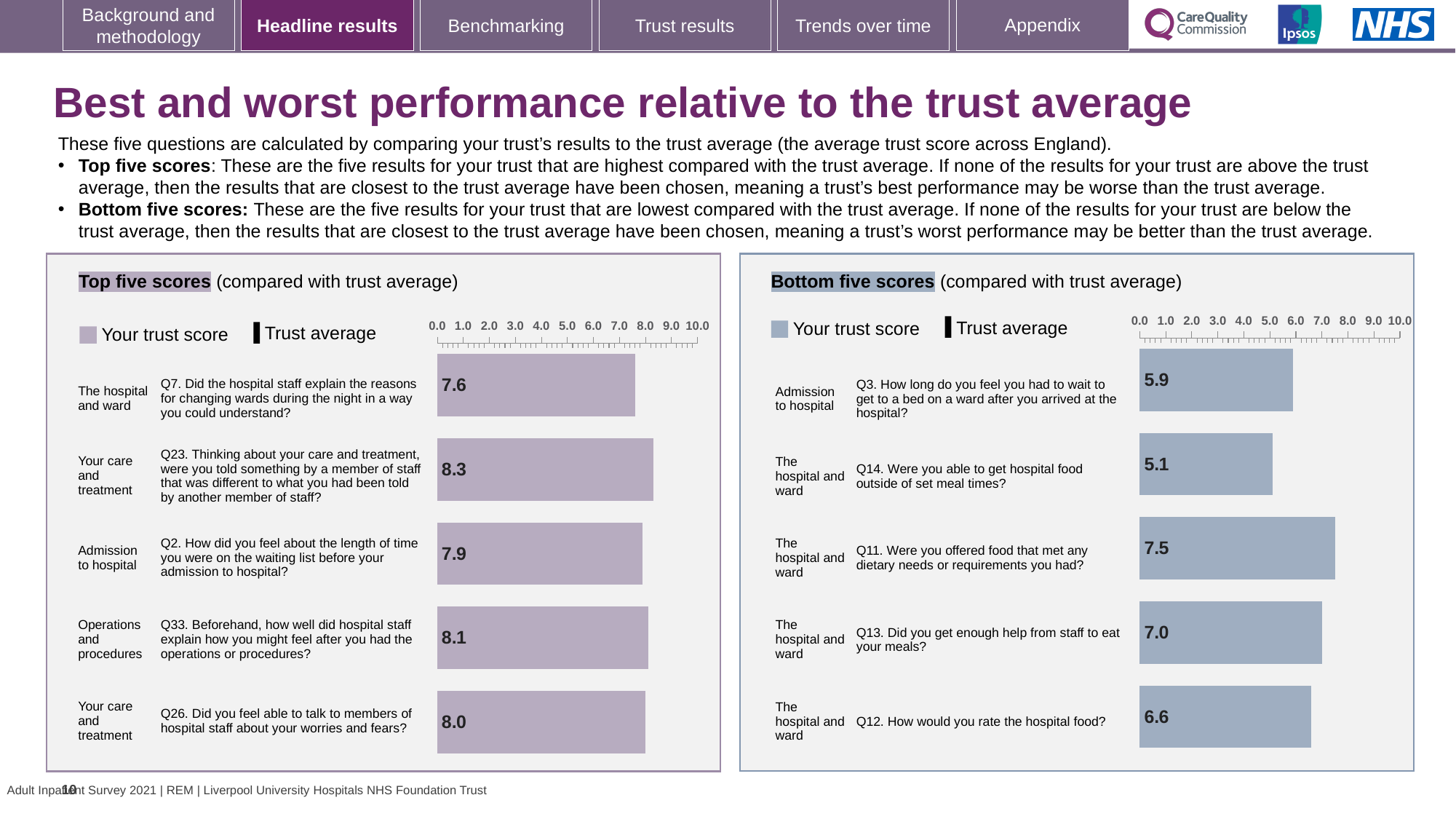
How many entries does the legend of the Top five scores chart list? 2 In the Top five scores chart, what is the difference between the scores for Q23 and Q7? 0.7 How many bars are shown in the Top five scores chart? 5 In the Top five scores chart, what is the trust score for Q7 about staff explaining the reasons for changing wards during the night? 7.6 In the Bottom five scores chart, which question has the lowest trust score? Q14 What kind of chart is the Bottom five scores chart? Bar chart In the Top five scores chart, which question has the highest trust score? Q23 In the Bottom five scores chart, which has the larger score, Q11 or Q13? Q11 In the Bottom five scores chart, what is the trust score for Q12, how would you rate the hospital food? 6.6 In the Bottom five scores chart, is the value for Q14 greater or less than 6.0? less In the Top five scores chart, what is the trust score for Q33 about explaining how you might feel after operations or procedures? 8.1 In the Bottom five scores chart, which question has the highest trust score? Q11